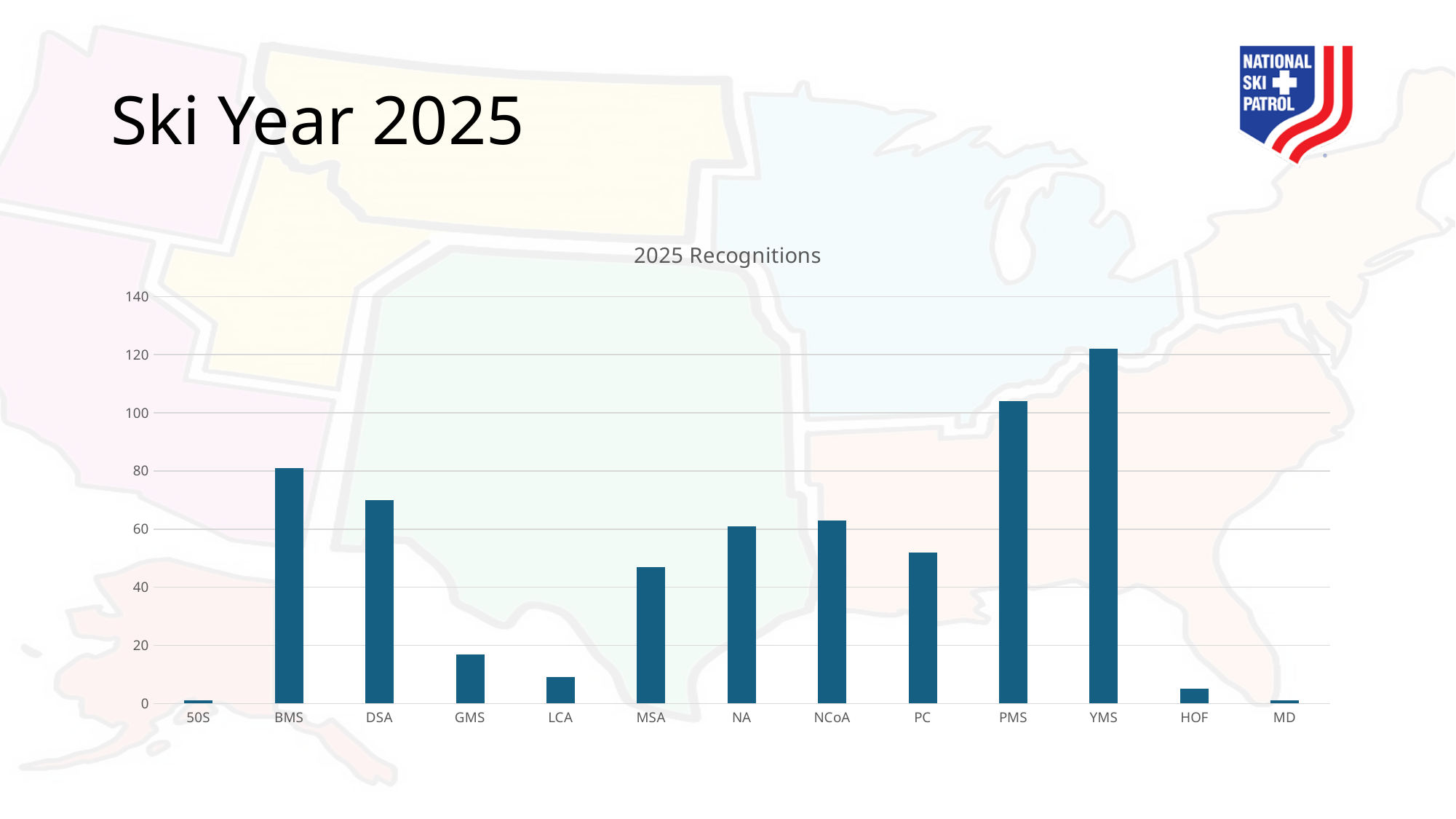
Is the value for BMS greater or less than 100? less Which category has the highest value in the chart? YMS Is the value for YMS greater or less than 100? greater What type of chart is shown on the slide? bar chart Is the value for MSA greater or less than 40? greater Which is larger, the value for DSA or the value for MSA? DSA What is the title of the chart? 2025 Recognitions How many categories are shown on the x axis of the chart? 13 Which is larger, the value for PMS or the value for BMS? PMS